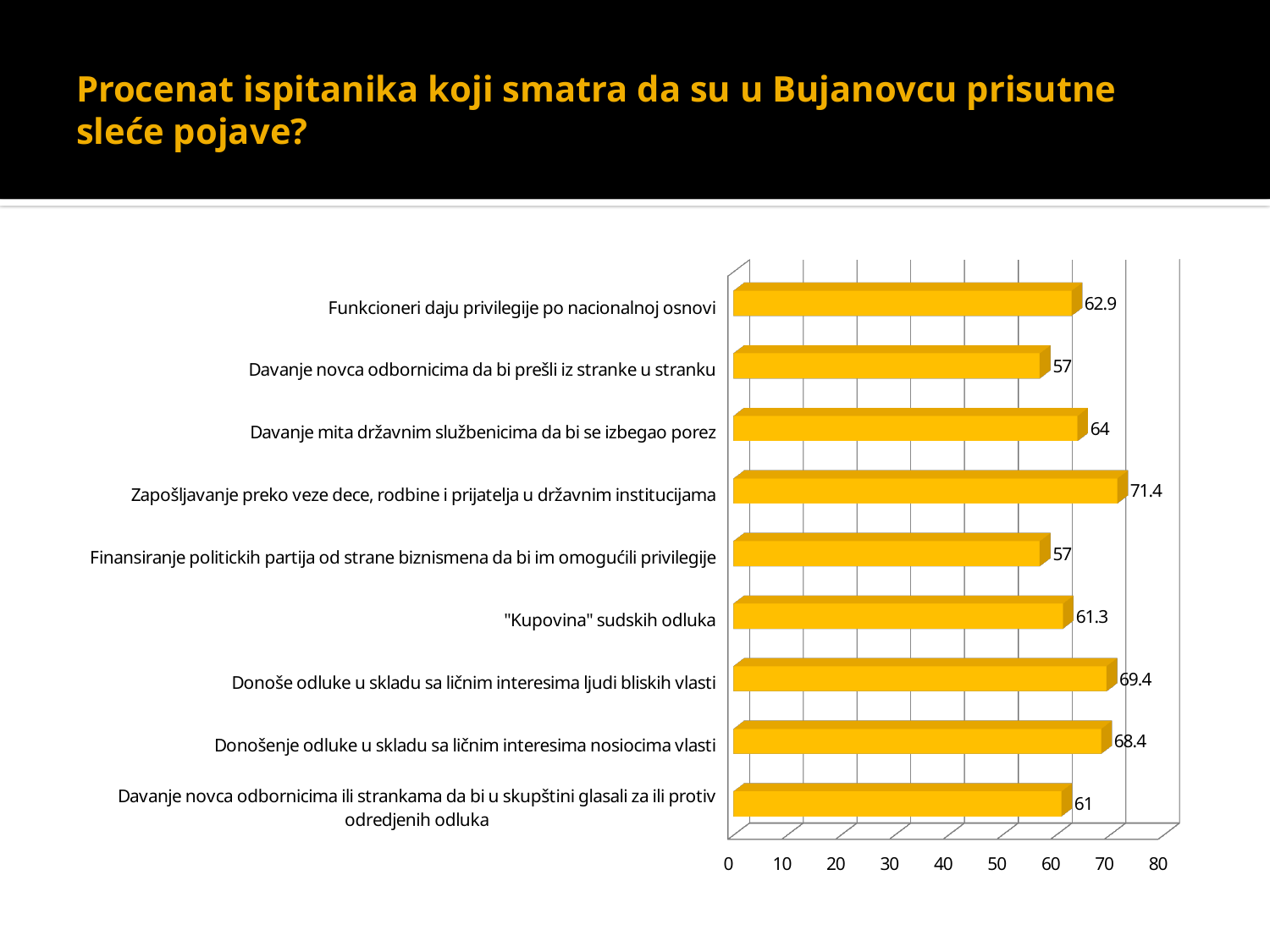
Which category has the highest value? Zapošljavanje preko veze dece, rodbine i prijatelja u državnim institucijama What is the value for "Zapošljavanje preko veze dece, rodbine i prijatelja u državnim institucijama"? 71.4 How many categories are plotted in the chart? 9 What is the lowest value shown in the chart? 57 Which is larger: the value for "Davanje mita državnim službenicima da bi se izbegao porez" or the value for "Funkcioneri daju privilegije po nacionalnoj osnovi"? Davanje mita državnim službenicima da bi se izbegao porez What is the value for "Funkcioneri daju privilegije po nacionalnoj osnovi"? 62.9 What is the title of the chart on the slide? Procenat ispitanika koji smatra da su u Bujanovcu prisutne sleće pojave? What is the value for "Kupovina" sudskih odluka? 61.3 What is the value for "Davanje mita državnim službenicima da bi se izbegao porez"? 64 Is the value for "Davanje novca odbornicima ili strankama da bi u skupštini glasali za ili protiv odredjenih odluka" greater or less than 70? less What type of chart is shown on the slide? bar chart What is the difference between the values for "Donoše odluke u skladu sa ličnim interesima ljudi bliskih vlasti" and "Donošenje odluke u skladu sa ličnim interesima nosiocima vlasti"? 1